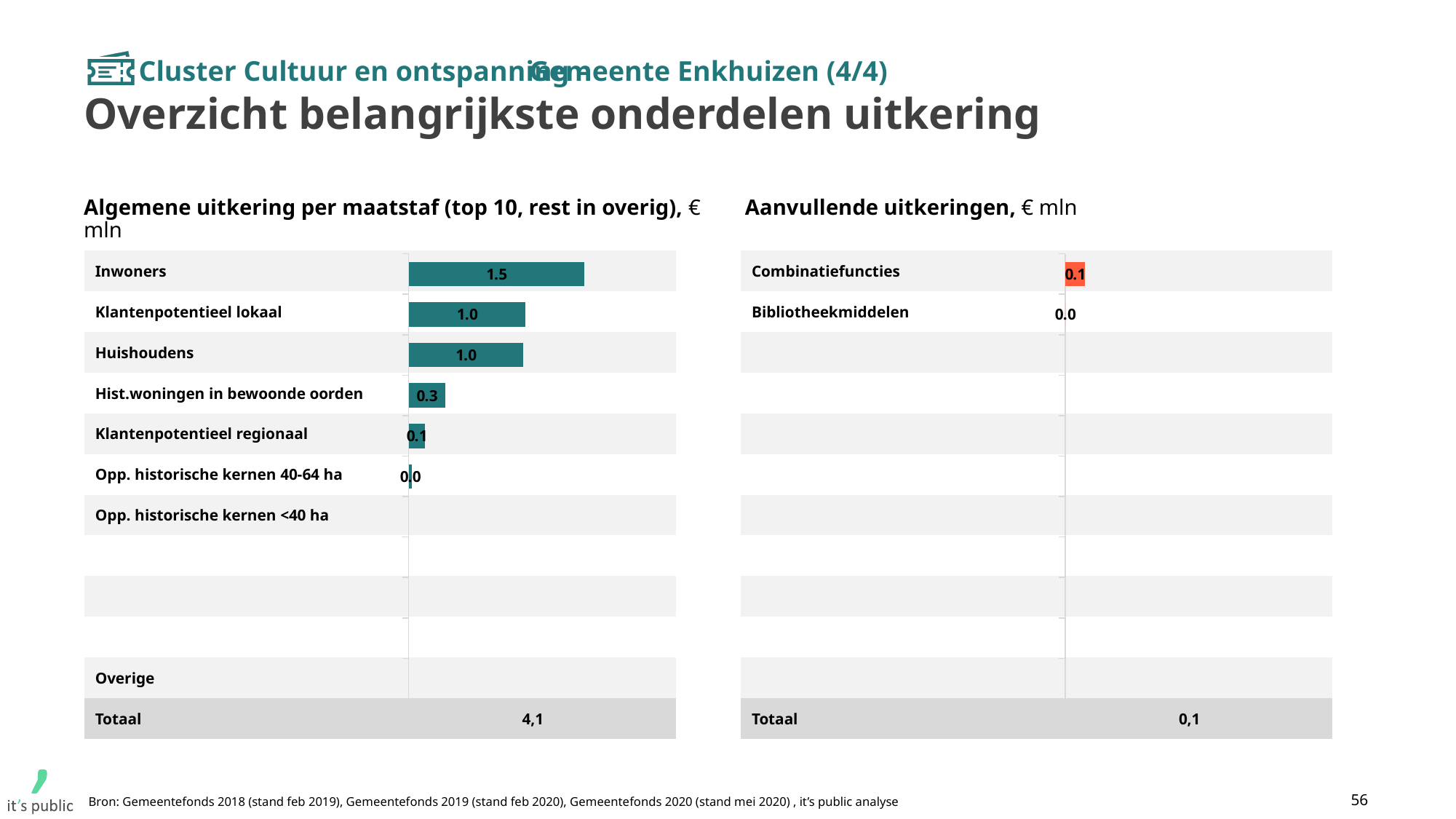
In the chart 'Algemene uitkering per maatstaf', what is the value for Hist.woningen in bewoonde oorden? 0.3 In the chart 'Aanvullende uitkeringen', what is the Totaal shown? 0,1 In the chart 'Algemene uitkering per maatstaf', what is the Totaal shown? 4,1 In the chart 'Algemene uitkering per maatstaf', what is the difference between the values for Inwoners and Hist.woningen in bewoonde oorden? 1.2 In the chart 'Algemene uitkering per maatstaf', what is the value for Inwoners? 1.5 In the chart 'Aanvullende uitkeringen', how many categories are labelled? 2 What kind of chart is the 'Algemene uitkering per maatstaf' chart? Bar chart In the chart 'Algemene uitkering per maatstaf', which is larger: the value for Huishoudens or for Hist.woningen in bewoonde oorden? Huishoudens In the chart 'Algemene uitkering per maatstaf', what is the difference between the values for Inwoners and Klantenpotentieel lokaal? 0.5 In the chart 'Aanvullende uitkeringen', what is the value for Combinatiefuncties? 0.1 In the chart 'Algemene uitkering per maatstaf', which category has the highest value? Inwoners In the chart 'Algemene uitkering per maatstaf', what is the value for Klantenpotentieel regionaal? 0.1